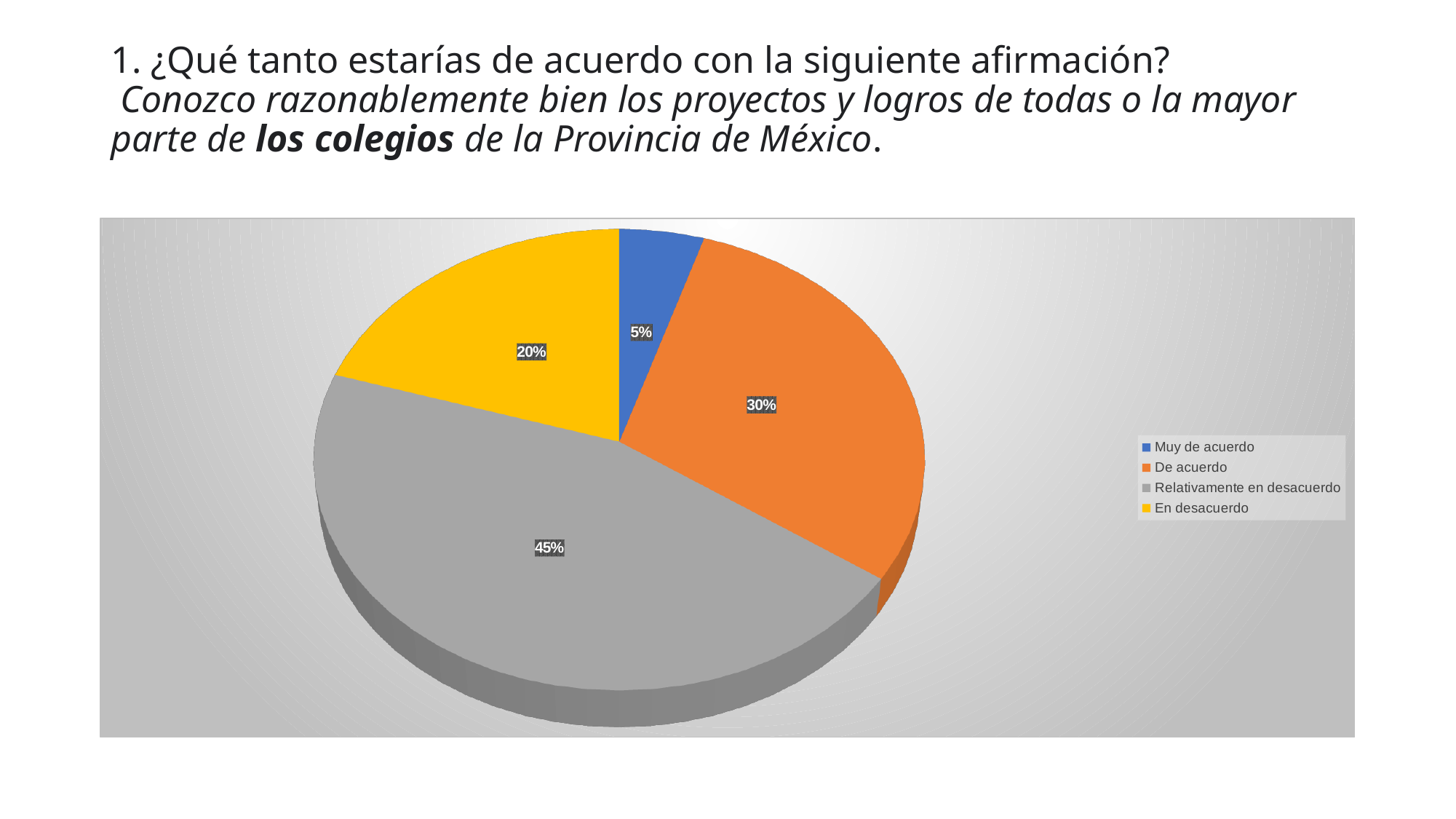
What is the combined share of "Muy de acuerdo" and "De acuerdo"? 35% What percentage of respondents answered "Relativamente en desacuerdo"? 45% What percentage of respondents answered "De acuerdo"? 30% What percentage of respondents answered "En desacuerdo"? 20% What kind of chart is shown on the slide? pie chart Which response category has the largest share of the pie? Relativamente en desacuerdo Which is larger, the share for "En desacuerdo" or the share for "De acuerdo"? De acuerdo What colour is the slice for "En desacuerdo"? yellow How many response categories does the pie chart show? 4 What percentage of respondents answered "Muy de acuerdo"? 5% Which response category has the smallest share of the pie? Muy de acuerdo What is the difference in percentage points between "Relativamente en desacuerdo" and "De acuerdo"? 15